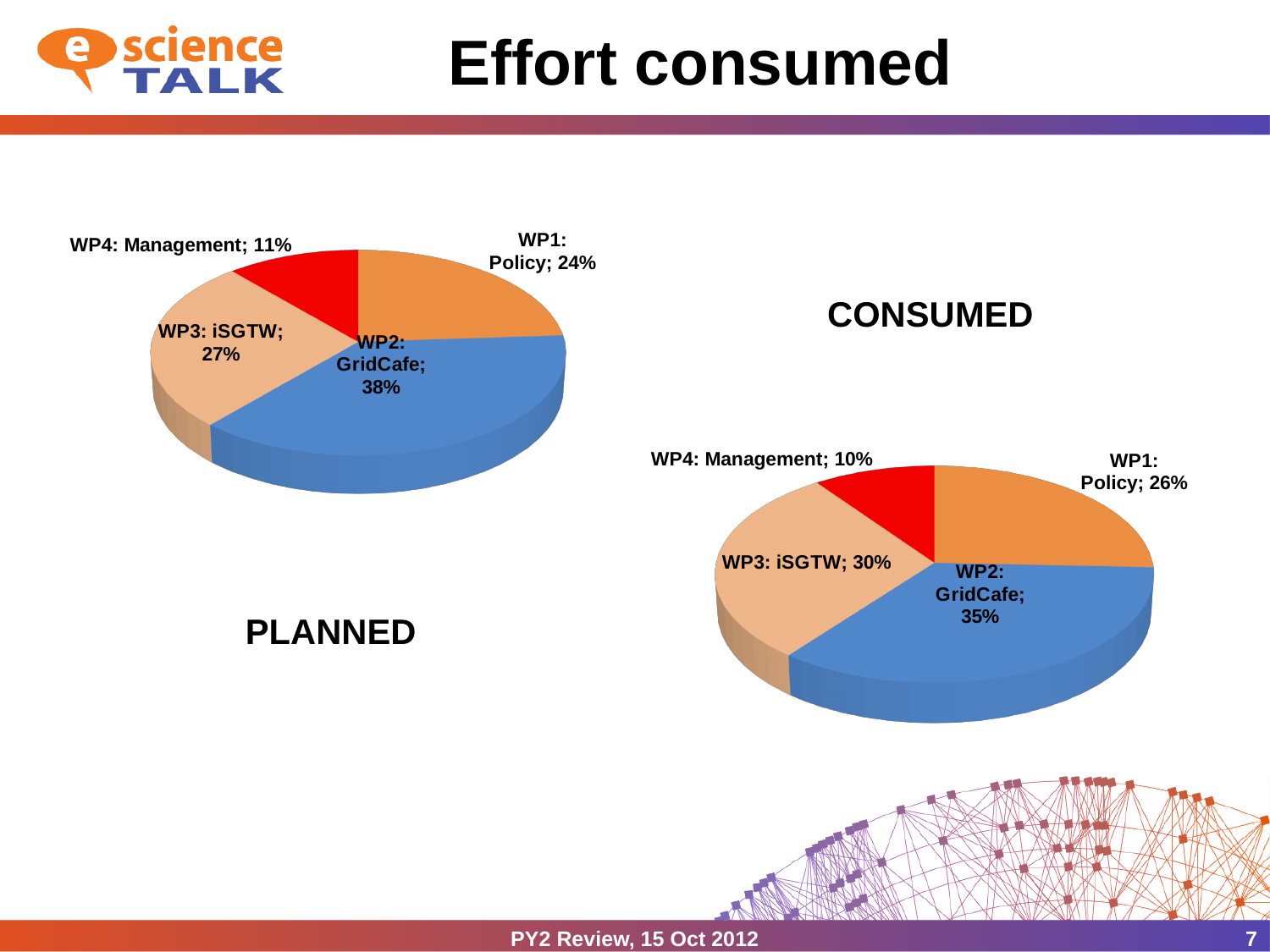
In the CONSUMED pie chart, what is the difference in percentage points between WP3: iSGTW and WP4: Management? 20 In the PLANNED pie chart, which work package has the largest share? WP2: GridCafe What type of chart is used for the CONSUMED data? Pie chart In the PLANNED pie chart, what share does WP2: GridCafe have? 38% In the PLANNED pie chart, what is the difference in percentage points between WP2: GridCafe and WP3: iSGTW? 11 In the CONSUMED pie chart, which work package has the smallest share? WP4: Management In the CONSUMED pie chart, what colour is the WP4: Management slice? Red How many slices does the PLANNED pie chart have? 4 In the CONSUMED pie chart, what share does WP1: Policy have? 26% Is the share of WP1: Policy larger in the PLANNED chart or the CONSUMED chart? CONSUMED In the CONSUMED pie chart, which is larger: WP2: GridCafe or WP3: iSGTW? WP2: GridCafe In the PLANNED pie chart, what share does WP4: Management have? 11%